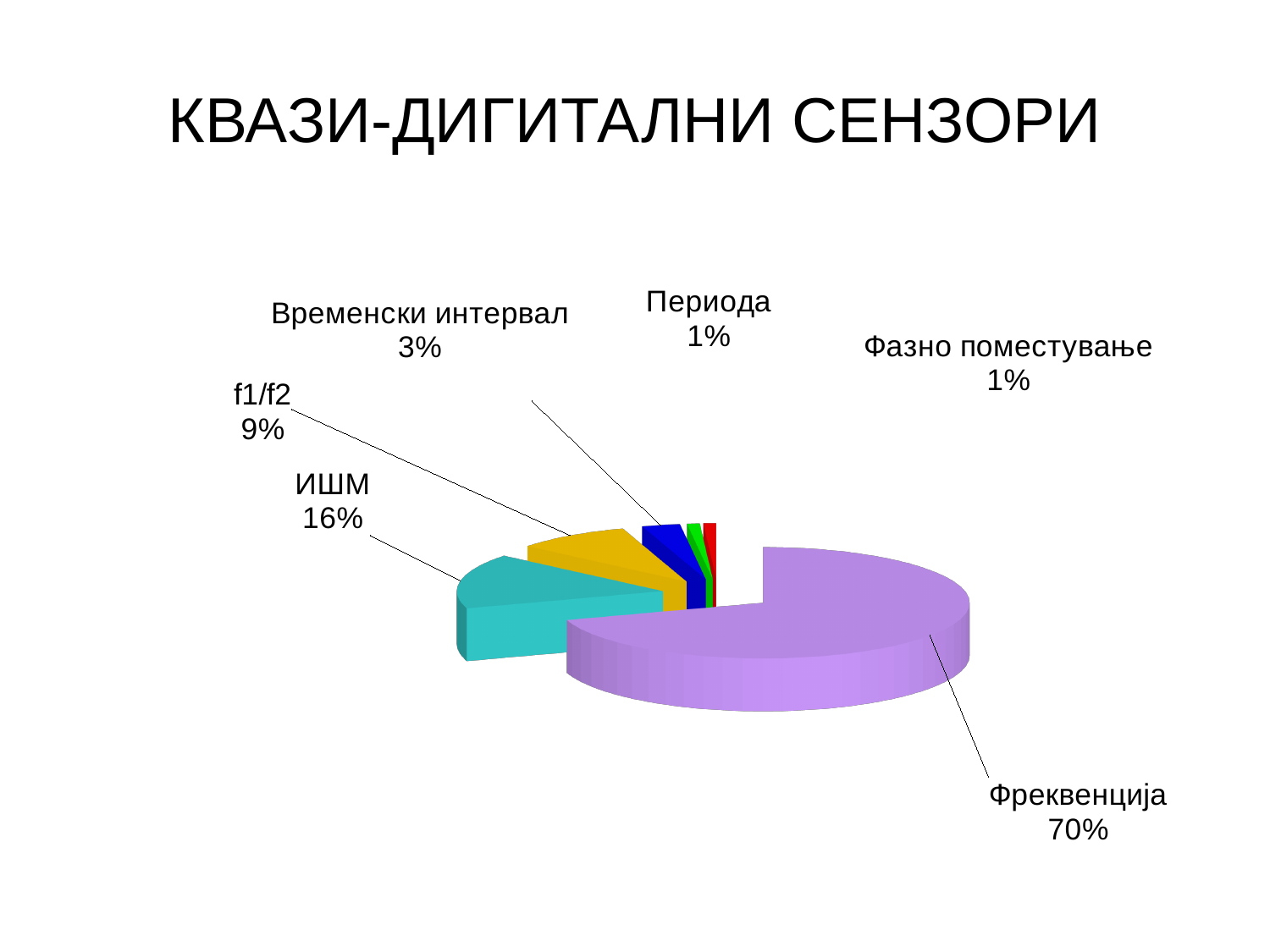
What is the difference between the shares of Фреквенција and ИШМ? 54% What is the value shown for f1/f2? 9% What is the title of the slide containing the pie chart? КВАЗИ-ДИГИТАЛНИ СЕНЗОРИ What is the value shown for ИШМ? 16% What is the value shown for Периода? 1% Which is larger, the share for f1/f2 or the share for Временски интервал? f1/f2 What share of the pie does Фреквенција have? 70% What kind of chart is shown on the slide? Pie chart Which category has the largest slice of the pie? Фреквенција What is the difference between the shares of ИШМ and f1/f2? 7% How many slices does the pie chart have? 6 What is the value shown for Временски интервал? 3%